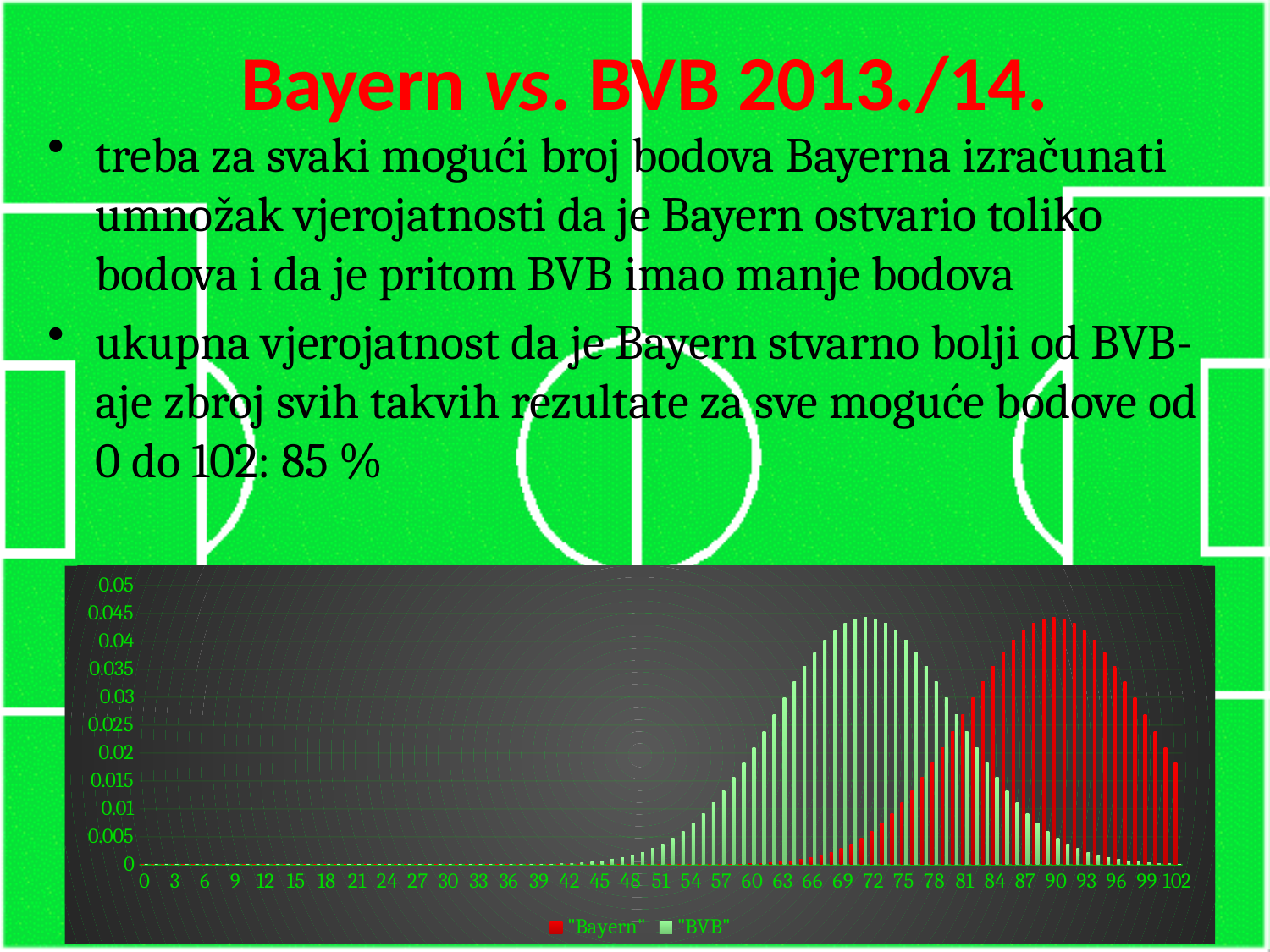
At 72 points, which series has the larger value, "Bayern" or "BVB"? "BVB" Is the value for "BVB" at 72 greater or less than 0.04? greater Is the value for "Bayern" at 60 greater or less than 0.005? less Is the value for "Bayern" at 102 greater or less than 0.01? greater How many series does the chart legend list? 2 Do the "BVB" values rise or fall along the x axis from 72 to 102? fall Which two series are listed in the chart legend? "Bayern" and "BVB" What kind of chart is shown on the slide? bar chart What colour are the bars for the "Bayern" series? red At 90 points, which series has the larger value, "Bayern" or "BVB"? "Bayern"